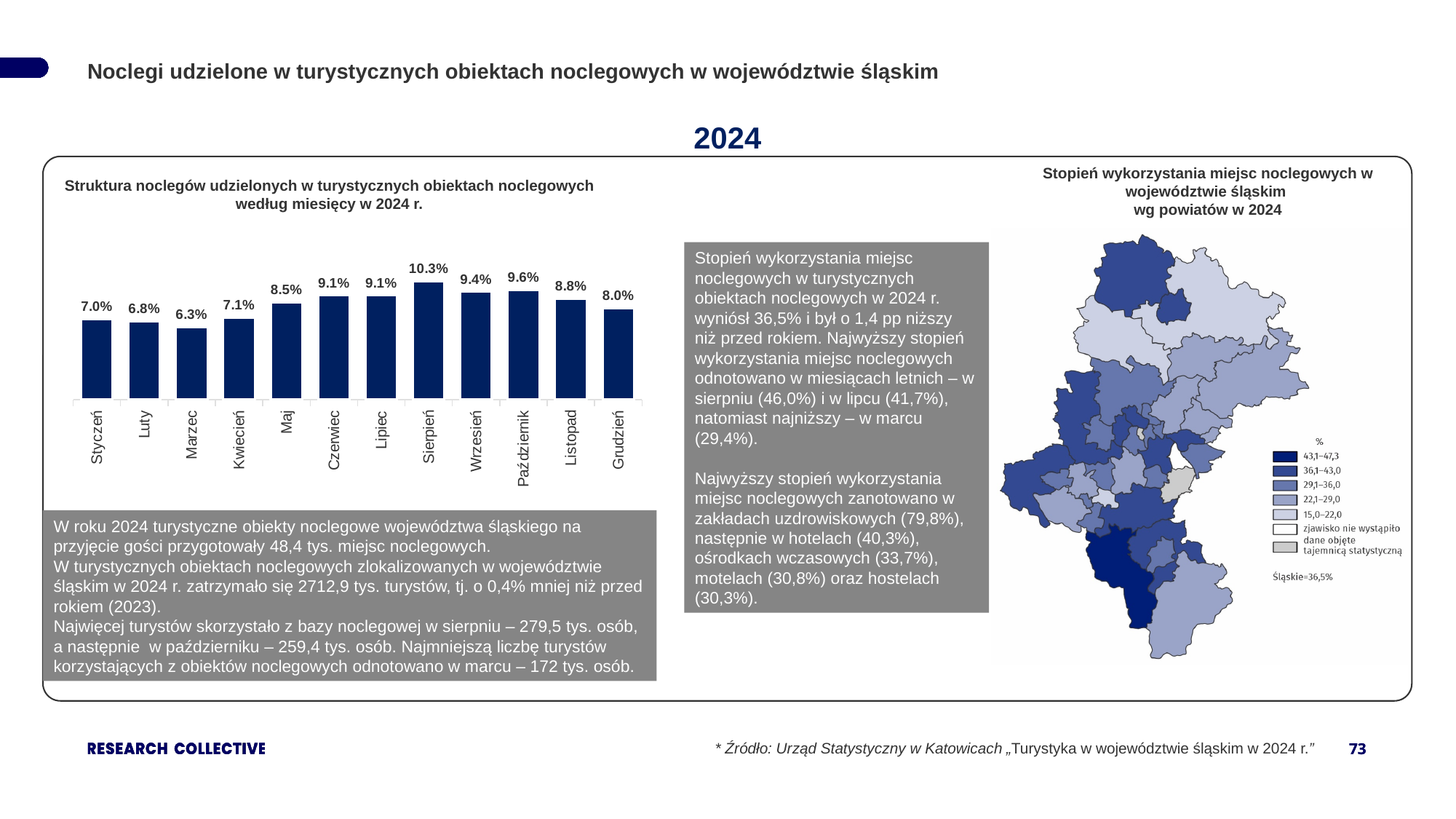
In the bar chart on the left, what is the value for Październik? 9.6% How many months (categories) are shown in the bar chart on the left? 12 In the bar chart on the left, what is the value for Marzec? 6.3% In the bar chart on the left, which month has the highest value? Sierpień In the bar chart on the left, which month has the lowest value? Marzec In the bar chart on the left, what is the difference between the values for Sierpień and Marzec? 4.0 percentage points In the bar chart on the left, which is larger: the value for Styczeń or the value for Luty? Styczeń In the bar chart 'Struktura noclegów udzielonych w turystycznych obiektach noclegowych według miesięcy w 2024 r.', what is the value for Sierpień? 10.3% In the bar chart on the left, what is the difference between the values for Październik and Wrzesień? 0.2 percentage points In the bar chart on the left, do the values rise or fall from Marzec to Sierpień? Rise In the bar chart on the left, which is larger: the value for Maj or the value for Listopad? Listopad What type of chart is used to show the structure of overnight stays by month in 2024? Bar chart